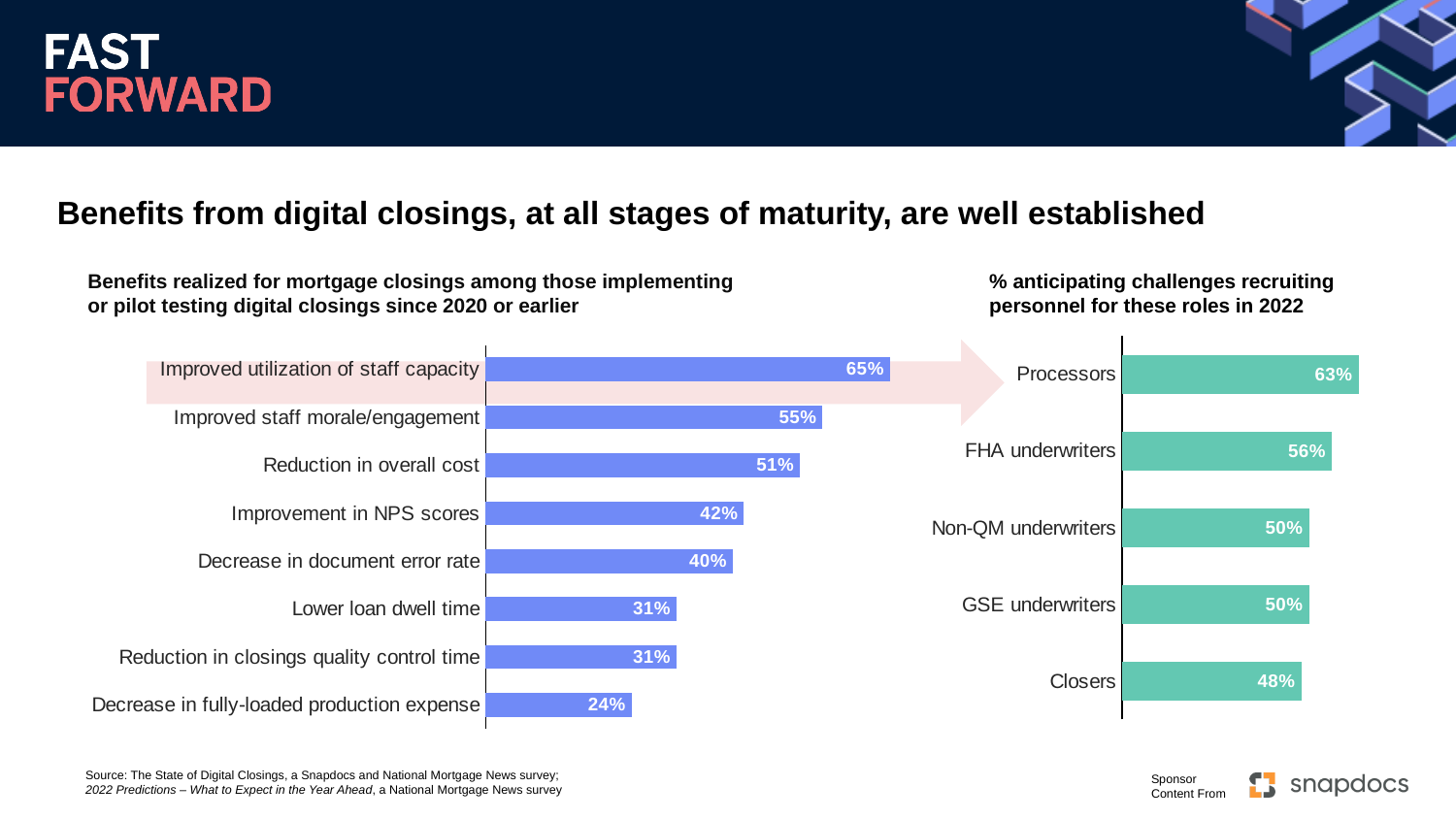
In the left chart (Benefits realized for mortgage closings), what is the value for Decrease in document error rate? 40% In the left chart (Benefits realized for mortgage closings), what is the value for Improved utilization of staff capacity? 65% In the left chart (Benefits realized for mortgage closings), what is the difference between Improved staff morale/engagement and Reduction in overall cost? 4% In the left chart (Benefits realized for mortgage closings), which is larger: Improvement in NPS scores or Lower loan dwell time? Improvement in NPS scores In the right chart (% anticipating challenges recruiting personnel), what is the difference between Processors and Closers? 15% In the left chart (Benefits realized for mortgage closings), which category has the lowest value? Decrease in fully-loaded production expense In the right chart (% anticipating challenges recruiting personnel), what is the value for FHA underwriters? 56% In the left chart (Benefits realized for mortgage closings), how many categories are shown? 8 What type of chart is the right chart (% anticipating challenges recruiting personnel)? Bar chart In the right chart (% anticipating challenges recruiting personnel), how many roles are shown? 5 What colour are the bars in the left chart (Benefits realized for mortgage closings)? Blue In the right chart (% anticipating challenges recruiting personnel), which role has the highest value? Processors